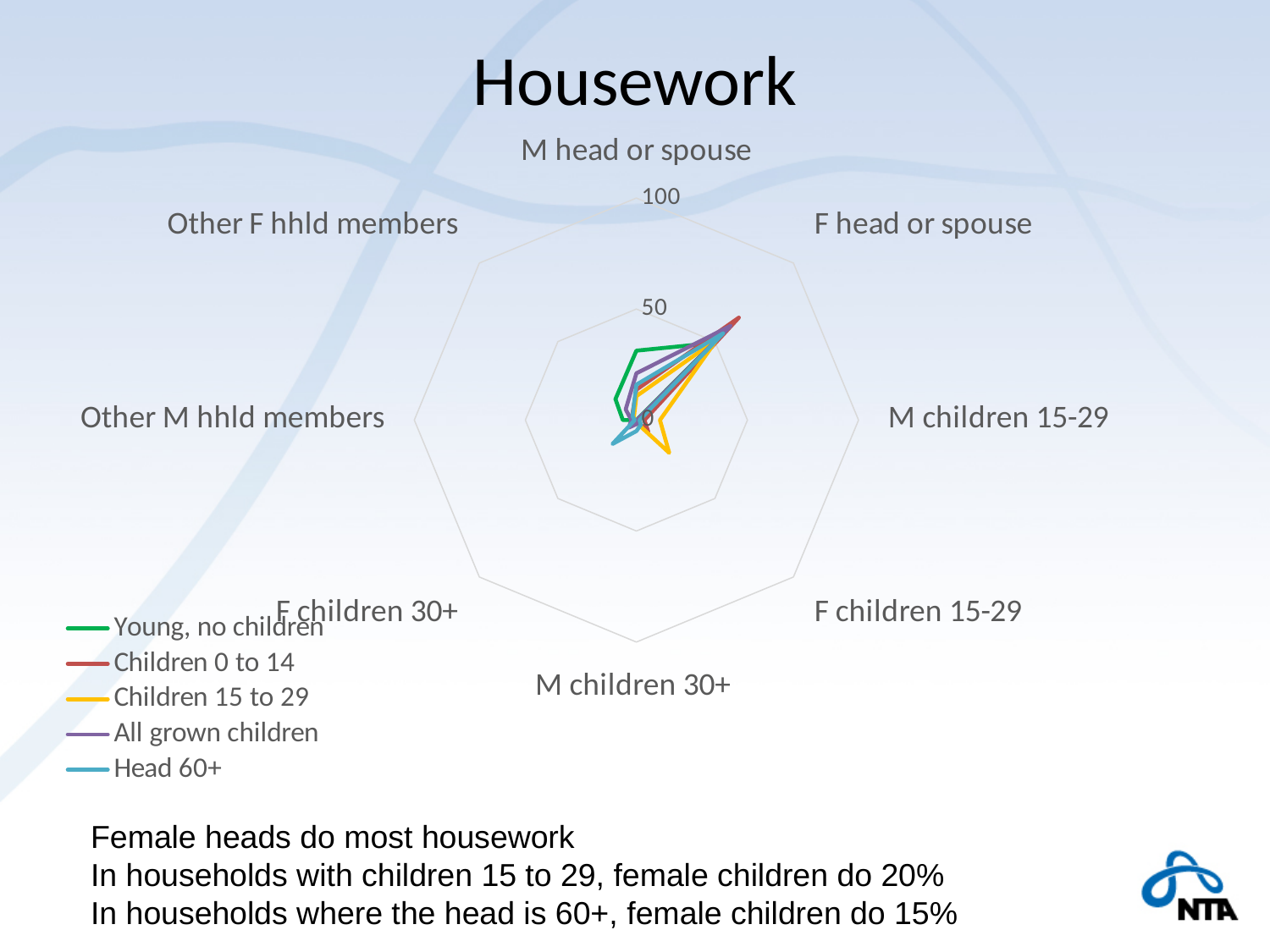
Which is larger for the Young, no children series: M head or spouse or M children 30+? M head or spouse Which category has the highest value for the Children 0 to 14 series? F head or spouse Is the value for M head or spouse in the Young, no children series greater or less than 50? less How many series does the legend list? 5 Is the value for Other M hhld members in the Head 60+ series greater or less than 50? less Is the value for F children 15-29 in the Children 15 to 29 series greater or less than 50? less Which category has the highest value for the Head 60+ series? F head or spouse How many categories (axes) does the radar chart have? 8 What is the title of the chart? Housework What kind of chart is shown on the slide? Radar chart What colour is the line for the Young, no children series? Green